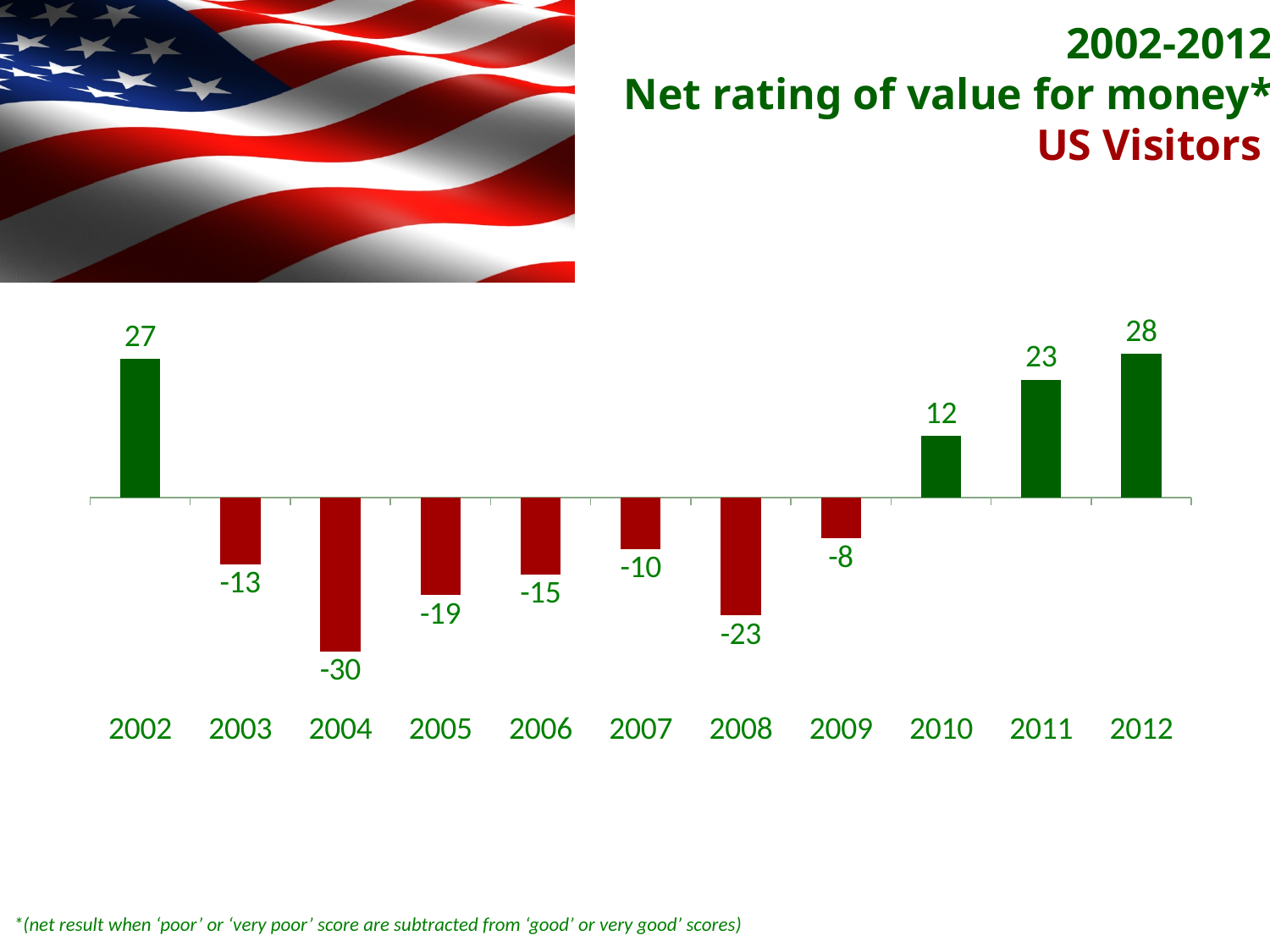
What is the net rating of value for money for US visitors in 2012? 28 Which year has a higher net rating, 2005 or 2007? 2007 How many years are shown on the chart? 11 What is the difference between the net rating in 2011 and the net rating in 2010? 11 What is the net rating of value for money for US visitors in 2004? -30 Does the net rating rise or fall from 2009 to 2012? Rise What is the net rating of value for money for US visitors in 2009? -8 What colour are the bars with negative values? Red What kind of chart is shown on the slide? Bar chart What is the difference between the net rating in 2012 and the net rating in 2002? 1 Which year has the highest net rating of value for money? 2012 Which year has the lowest net rating of value for money? 2004